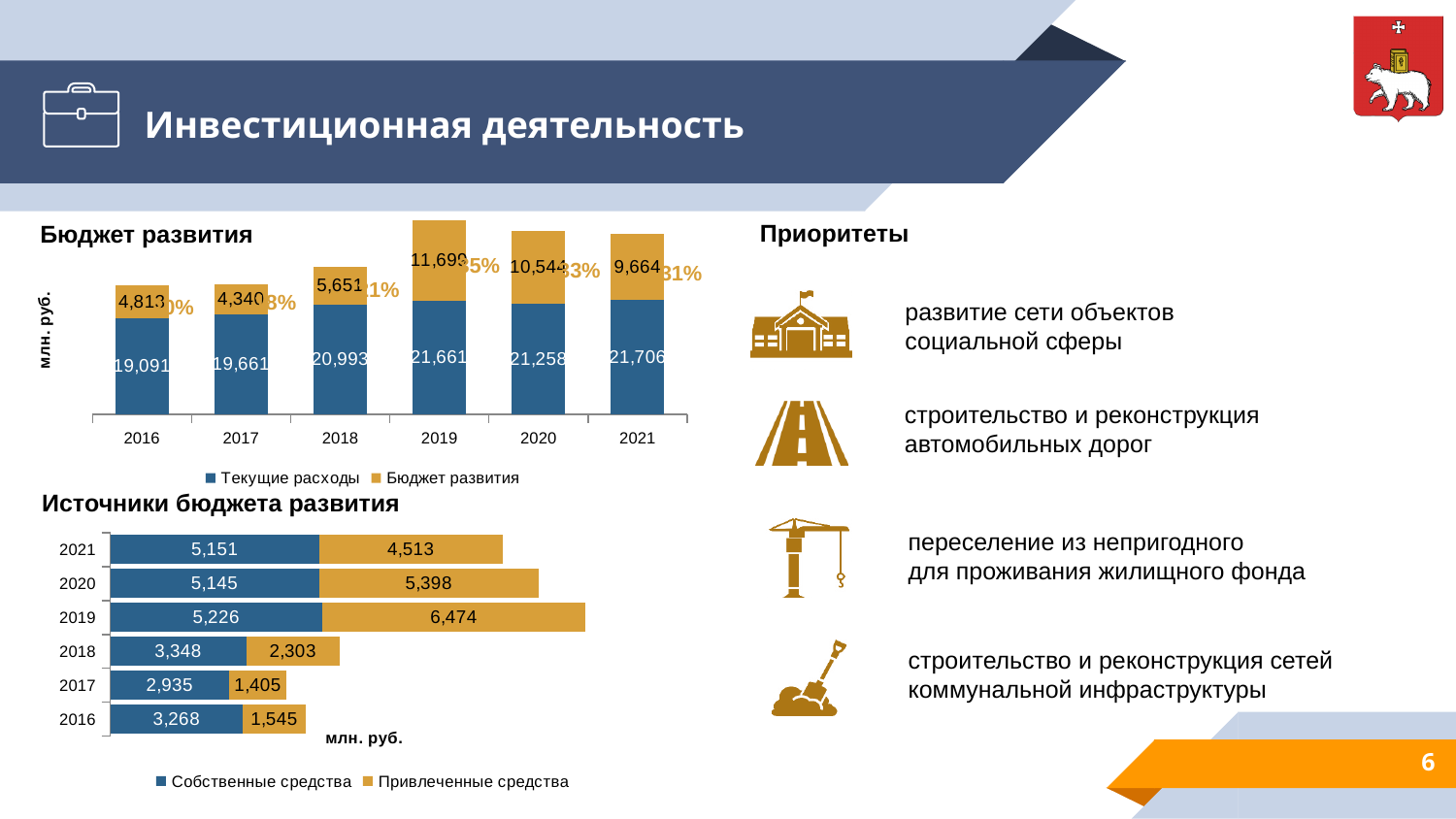
In the 'Источники бюджета развития' chart, what is the total of the 2021 bar? 9,664 In the 'Бюджет развития' chart, what is the difference between Бюджет развития in 2019 and in 2020? 1,155 In the 'Бюджет развития' chart, what is the value of Текущие расходы for 2016? 19,091 In the 'Бюджет развития' chart, what is the value of Бюджет развития for 2019? 11,699 In the 'Бюджет развития' chart, which year has the highest Бюджет развития value? 2019 In the 'Источники бюджета развития' chart, which year has the lowest Привлеченные средства value? 2017 In the 'Бюджет развития' chart, which year has the lowest Текущие расходы value? 2016 How many years are shown on the x axis of the 'Бюджет развития' chart? 6 What type of chart is 'Источники бюджета развития'? Stacked bar chart In the 'Бюджет развития' chart, how many series does the legend list? 2 In the 'Источники бюджета развития' chart, which is larger for 2020: Собственные средства or Привлеченные средства? Привлеченные средства In the 'Источники бюджета развития' chart, what is the value of Привлеченные средства for 2019? 6,474